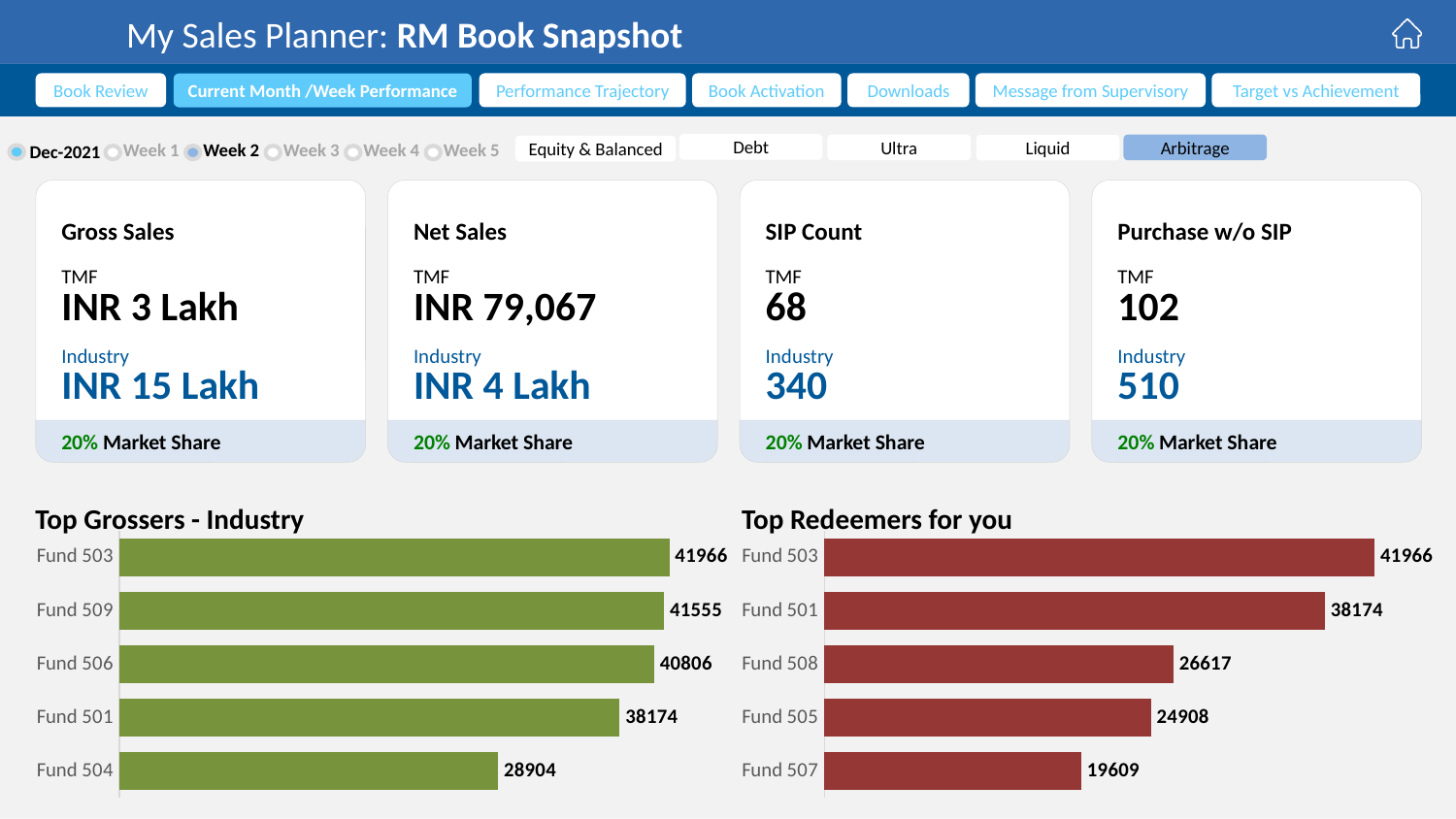
In the 'Top Grossers - Industry' chart, what is the difference between Fund 506 and Fund 501? 2632 In the 'Top Redeemers for you' chart, what is the value for Fund 508? 26617 What type of chart is 'Top Redeemers for you'? Bar chart In the 'Top Redeemers for you' chart, which fund has the highest value? Fund 503 What colour are the bars in the 'Top Grossers - Industry' chart? Green In the 'Top Grossers - Industry' chart, what is the value for Fund 509? 41555 In the 'Top Grossers - Industry' chart, what is the value for Fund 504? 28904 In the 'Top Redeemers for you' chart, what is the difference between Fund 503 and Fund 507? 22357 In the 'Top Grossers - Industry' chart, which fund has the lowest value? Fund 504 How many funds are shown in the 'Top Redeemers for you' chart? 5 How many funds are shown in the 'Top Grossers - Industry' chart? 5 In the 'Top Redeemers for you' chart, which is larger, the value for Fund 505 or Fund 507? Fund 505